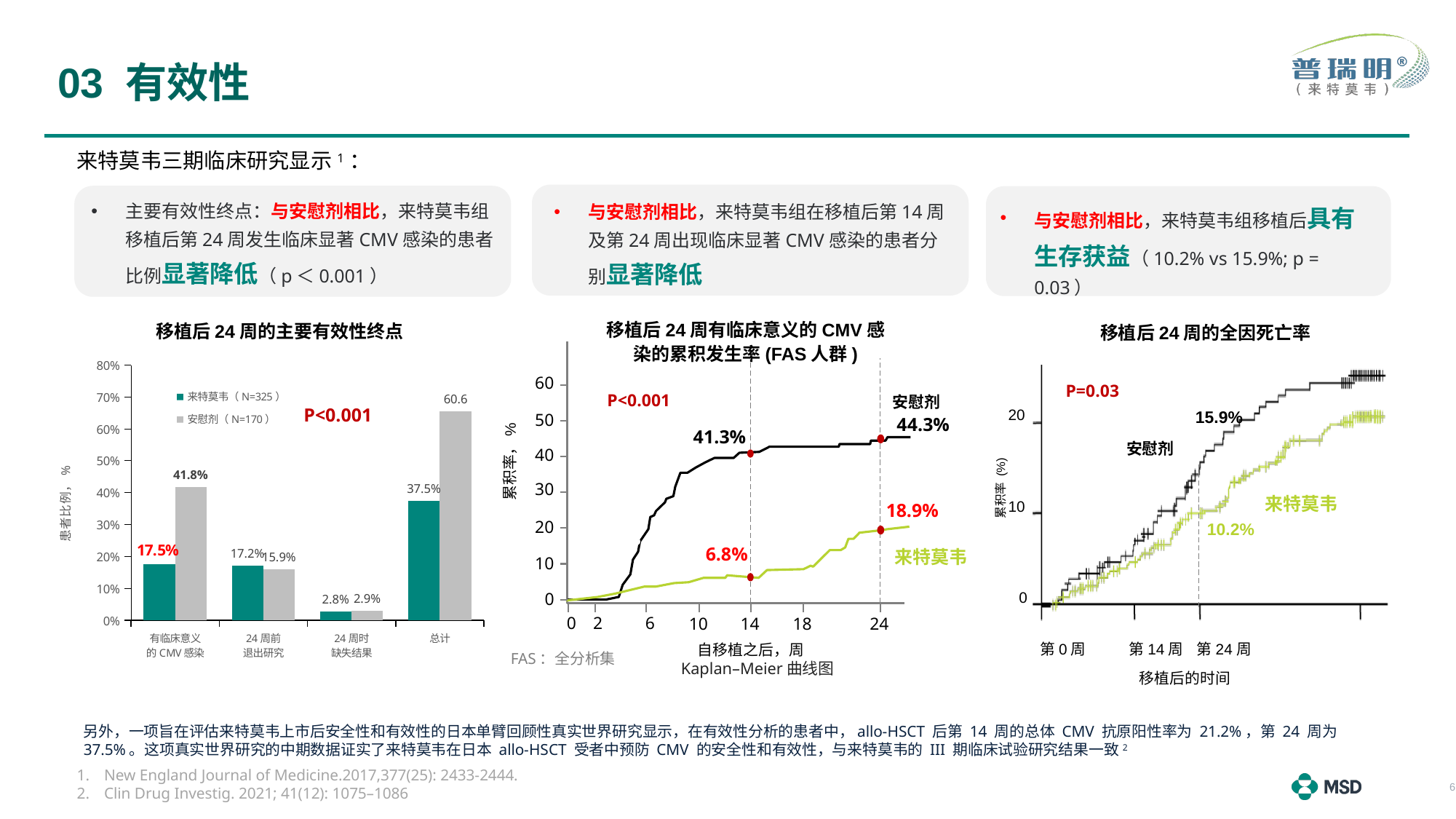
In the right chart titled 移植后 24 周的全因死亡率, what is the difference between the 安慰剂 and 来特莫韦 rates at week 24? 5.7% In the middle Kaplan–Meier chart, what is the cumulative rate for 来特莫韦 at week 14? 6.8% In the bar chart titled 移植后 24 周的主要有效性终点, what is the value for 来特莫韦 in the 有临床意义的 CMV 感染 category? 17.5% What kind of chart is the middle chart titled 移植后 24 周有临床意义的 CMV 感染的累积发生率 (FAS 人群)? Line chart (Kaplan–Meier curve) In the bar chart titled 移植后 24 周的主要有效性终点, what is the difference between the 安慰剂 and 来特莫韦 values in the 有临床意义的 CMV 感染 category? 24.3% In the bar chart titled 移植后 24 周的主要有效性终点, what is the 总计 value for 安慰剂? 60.6 In the bar chart titled 移植后 24 周的主要有效性终点, which category has the lowest value for 来特莫韦? 24 周时缺失结果 In the bar chart titled 移植后 24 周的主要有效性终点, how many series does the legend list? 2 In the bar chart titled 移植后 24 周的主要有效性终点, how many categories are shown on the x axis? 4 In the bar chart titled 移植后 24 周的主要有效性终点, what is the value for 安慰剂 in the 有临床意义的 CMV 感染 category? 41.8% In the bar chart titled 移植后 24 周的主要有效性终点, which series has the larger value in the 24 周前退出研究 category? 来特莫韦 In the middle Kaplan–Meier chart, what is the cumulative rate for 安慰剂 at week 24? 44.3%